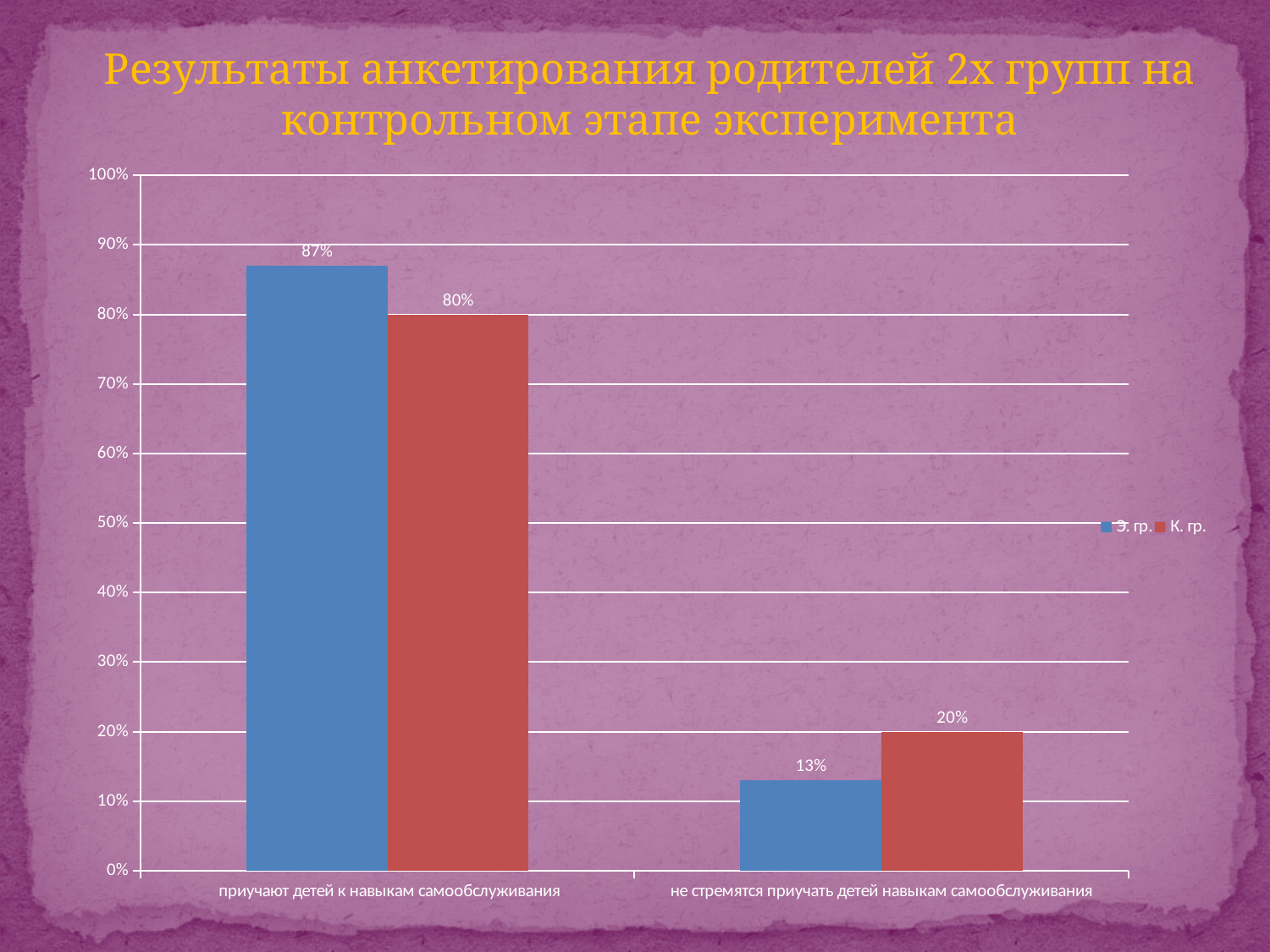
What is the difference between the Э. гр. and К. гр. values in the category 'приучают детей к навыкам самообслуживания'? 7% What is the value for Э. гр. in the category 'не стремятся приучать детей навыкам самообслуживания'? 13% What is the value for К. гр. in the category 'не стремятся приучать детей навыкам самообслуживания'? 20% How many series does the legend list? 2 What is the value for Э. гр. in the category 'приучают детей к навыкам самообслуживания'? 87% What kind of chart is shown on the slide? bar chart Which series has the highest value in the category 'приучают детей к навыкам самообслуживания'? Э. гр. What is the value for К. гр. in the category 'приучают детей к навыкам самообслуживания'? 80% How many categories are shown on the x axis? 2 Which is larger: the К. гр. value for 'приучают детей к навыкам самообслуживания' or the К. гр. value for 'не стремятся приучать детей навыкам самообслуживания'? приучают детей к навыкам самообслуживания What is the difference between the К. гр. and Э. гр. values in the category 'не стремятся приучать детей навыкам самообслуживания'? 7% Which series has the lowest value in the category 'не стремятся приучать детей навыкам самообслуживания'? Э. гр.